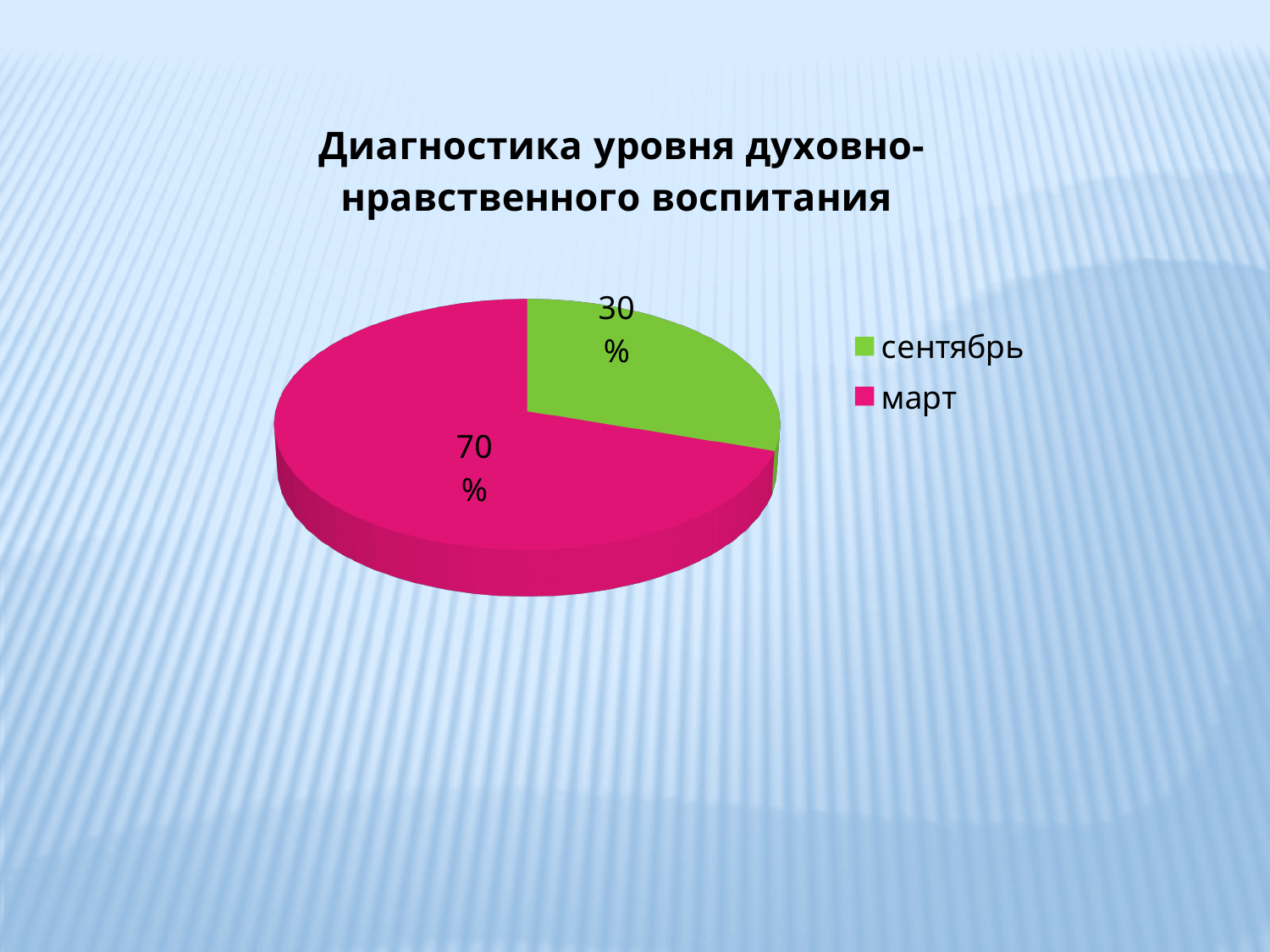
How many entries does the legend list? 2 What kind of chart is shown on the slide? pie chart What is the value for сентябрь? 30% What is the value for март? 70% What share of the pie does the март slice represent? 70% How many slices does the pie chart have? 2 What is the difference between the values for март and сентябрь? 40% What colour is the slice for сентябрь? green Which category has the largest slice? март What is the title of the chart? Диагностика уровня духовно-нравственного воспитания Which is larger, the value for сентябрь or the value for март? март Which category has the smallest slice? сентябрь